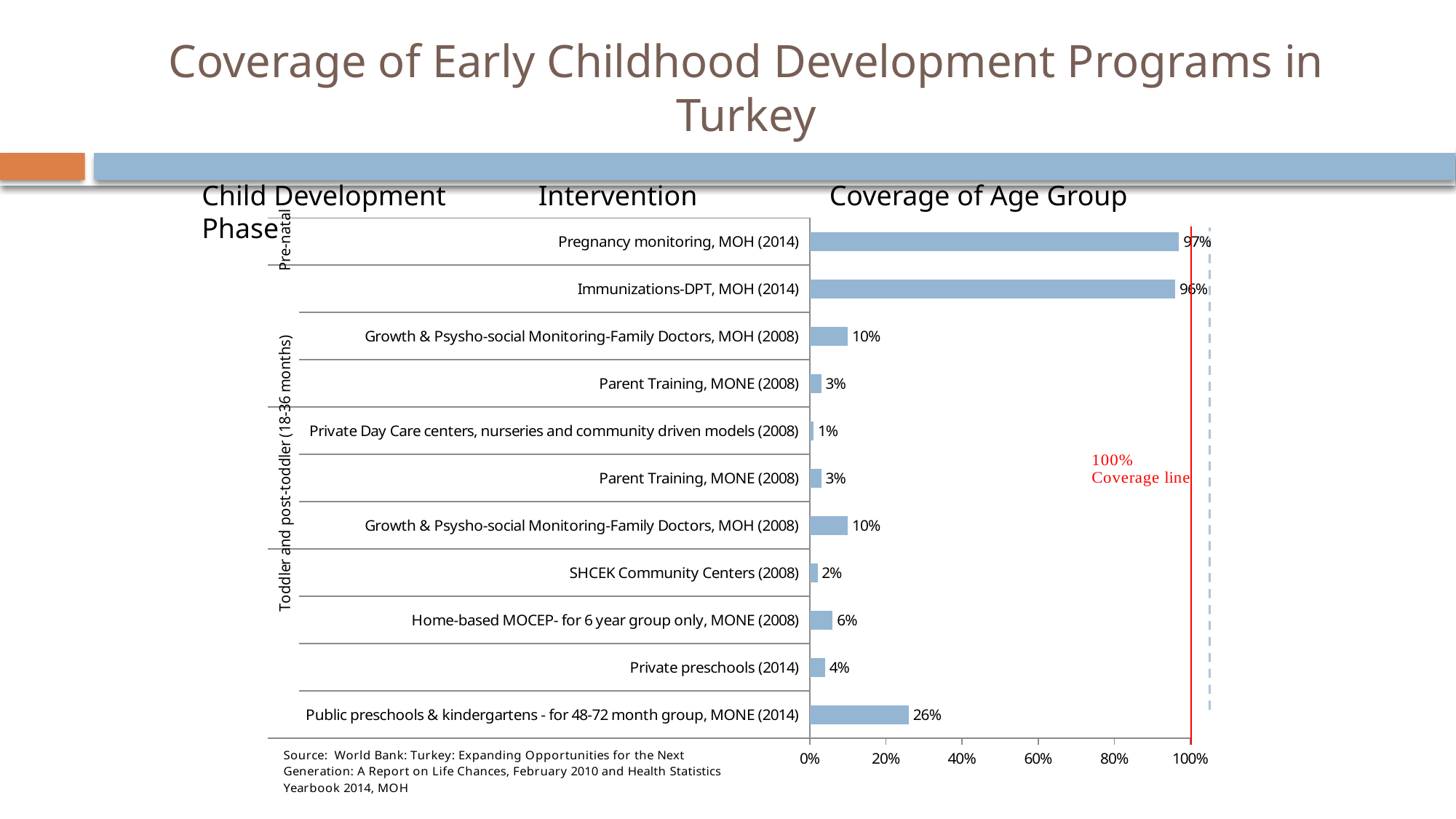
Is the coverage value for Immunizations-DPT, MOH (2014) greater or less than 80%? greater What is the difference in coverage between Pregnancy monitoring, MOH (2014) and Immunizations-DPT, MOH (2014)? 1% What is the coverage value for Public preschools & kindergartens - for 48-72 month group, MONE (2014)? 26% How many interventions (bars) are shown in the chart? 11 Which intervention has the lowest coverage? Private Day Care centers, nurseries and community driven models (2008) What type of chart is shown on the slide? Bar chart What is the coverage value for Home-based MOCEP- for 6 year group only, MONE (2008)? 6% What is the coverage value for Pregnancy monitoring, MOH (2014)? 97% What is the coverage value for Private preschools (2014)? 4% What does the red vertical line in the chart represent? 100% Coverage line Which has higher coverage: Public preschools & kindergartens - for 48-72 month group, MONE (2014) or Private preschools (2014)? Public preschools & kindergartens - for 48-72 month group, MONE (2014) Which intervention has the highest coverage? Pregnancy monitoring, MOH (2014)